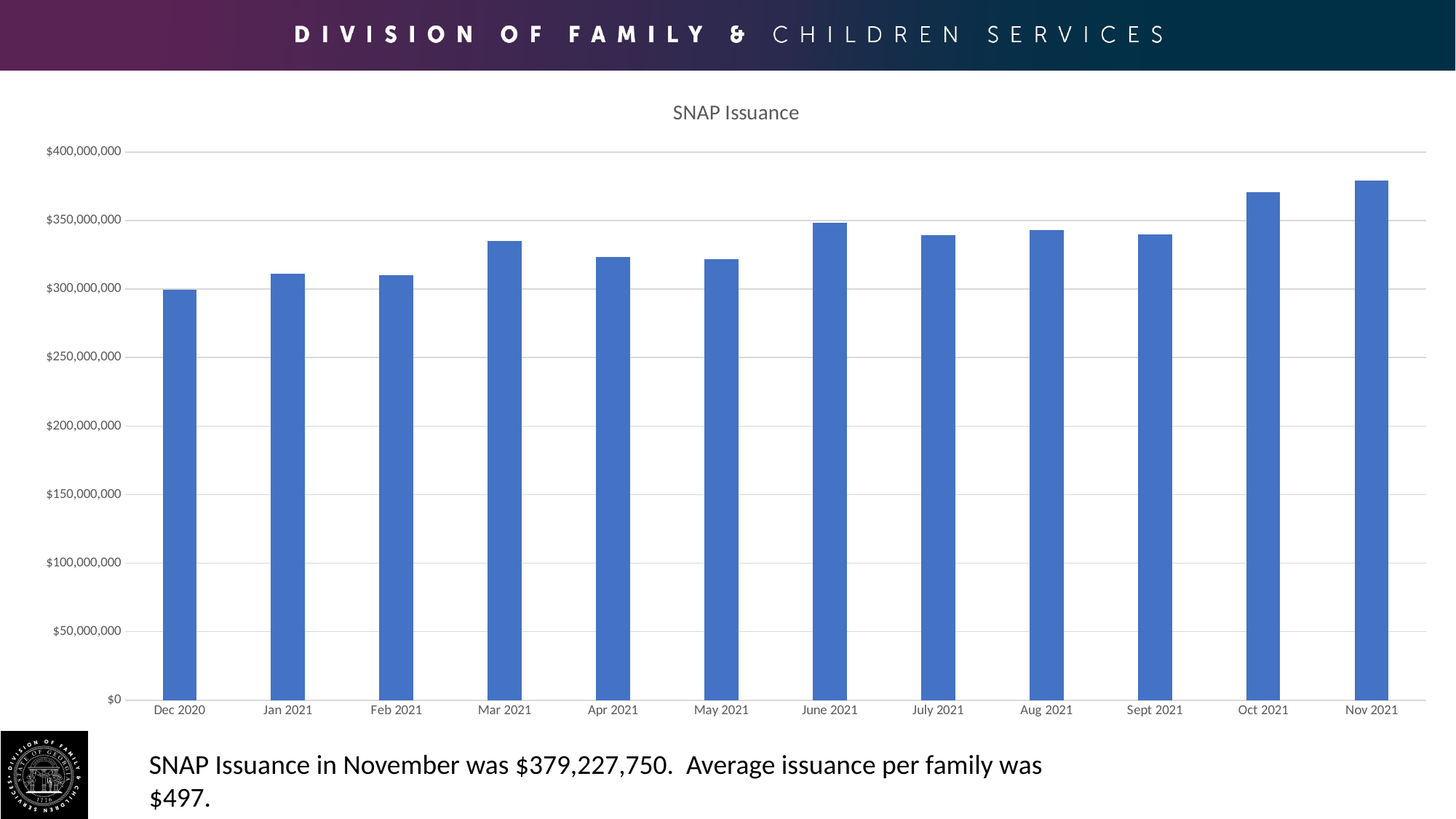
Which month has the lowest SNAP Issuance? Dec 2020 Which is larger, the value for June 2021 or the value for May 2021? June 2021 How many months are plotted on the chart? 12 Overall, do the values rise or fall from Dec 2020 to Nov 2021? rise Which month has the highest SNAP Issuance? Nov 2021 What is the title of the chart? SNAP Issuance Is the value for Oct 2021 greater or less than $350,000,000? greater What was the SNAP Issuance for Nov 2021? $379,227,750 Which is larger, the value for Mar 2021 or the value for Feb 2021? Mar 2021 What kind of chart is shown on the slide? bar chart Is the value for Dec 2020 greater or less than $350,000,000? less Is the value for Mar 2021 greater or less than $300,000,000? greater